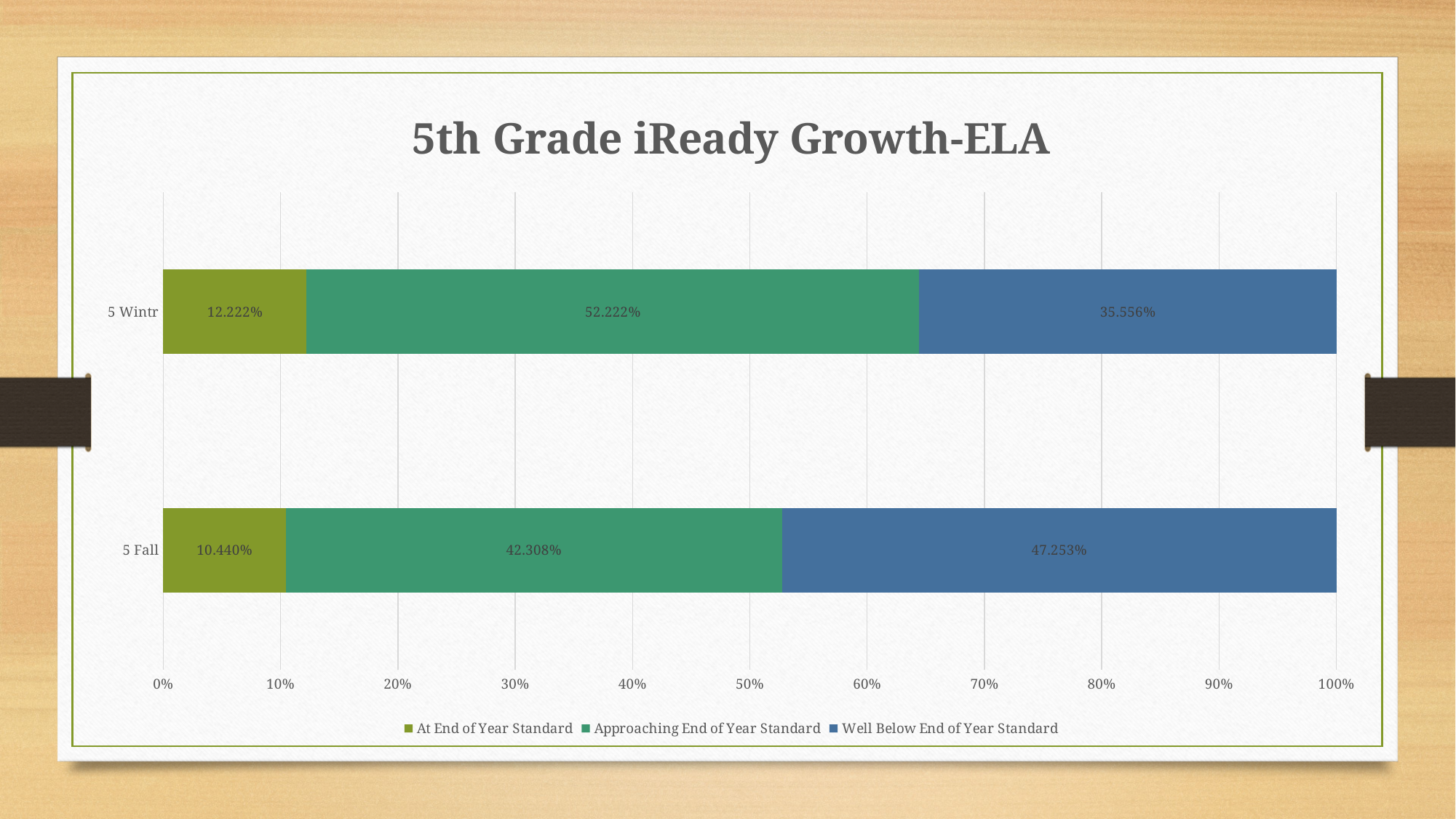
How many categories are shown on the vertical axis? 2 What is the title of the chart? 5th Grade iReady Growth-ELA What is the value for Well Below End of Year Standard in 5 Wintr? 35.556% What is the difference between the Well Below End of Year Standard values for 5 Fall and 5 Wintr? 11.697% What is the value for At End of Year Standard in 5 Wintr? 12.222% What is the value for Approaching End of Year Standard in 5 Fall? 42.308% What is the difference between the Approaching End of Year Standard values for 5 Wintr and 5 Fall? 9.914% How many series does the legend list? 3 Which series is shown in blue in the legend? Well Below End of Year Standard Which category has the higher value for Approaching End of Year Standard, 5 Wintr or 5 Fall? 5 Wintr What type of chart is shown on the slide? Stacked bar chart What is the value for Well Below End of Year Standard in 5 Fall? 47.253%